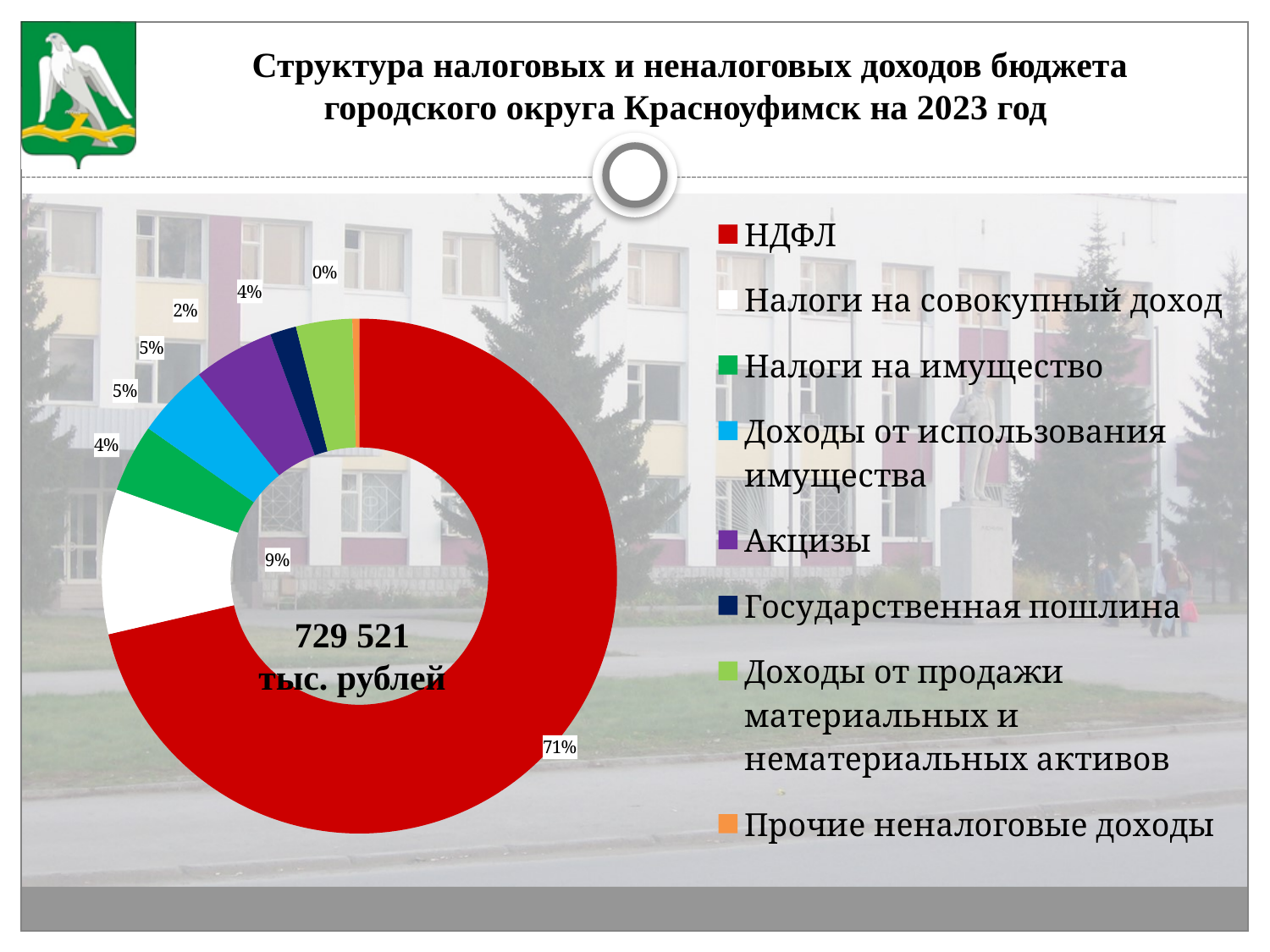
What share is shown for Прочие неналоговые доходы? 0% What share is shown for Акцизы? 5% What share is shown for Государственная пошлина? 2% Which has the larger share: Налоги на совокупный доход or Налоги на имущество? Налоги на совокупный доход What total amount is printed in the centre of the chart? 729 521 тыс. рублей Which category has the largest share of the revenue? НДФЛ By how many percentage points does the share of НДФЛ exceed the share of Налоги на совокупный доход? 62 percentage points How many categories does the legend list? 8 What share of the budget revenue does НДФЛ account for? 71% What kind of chart is shown on the slide? Doughnut (pie) chart What share is shown for Налоги на совокупный доход? 9% Which category has the smallest share of the revenue? Прочие неналоговые доходы